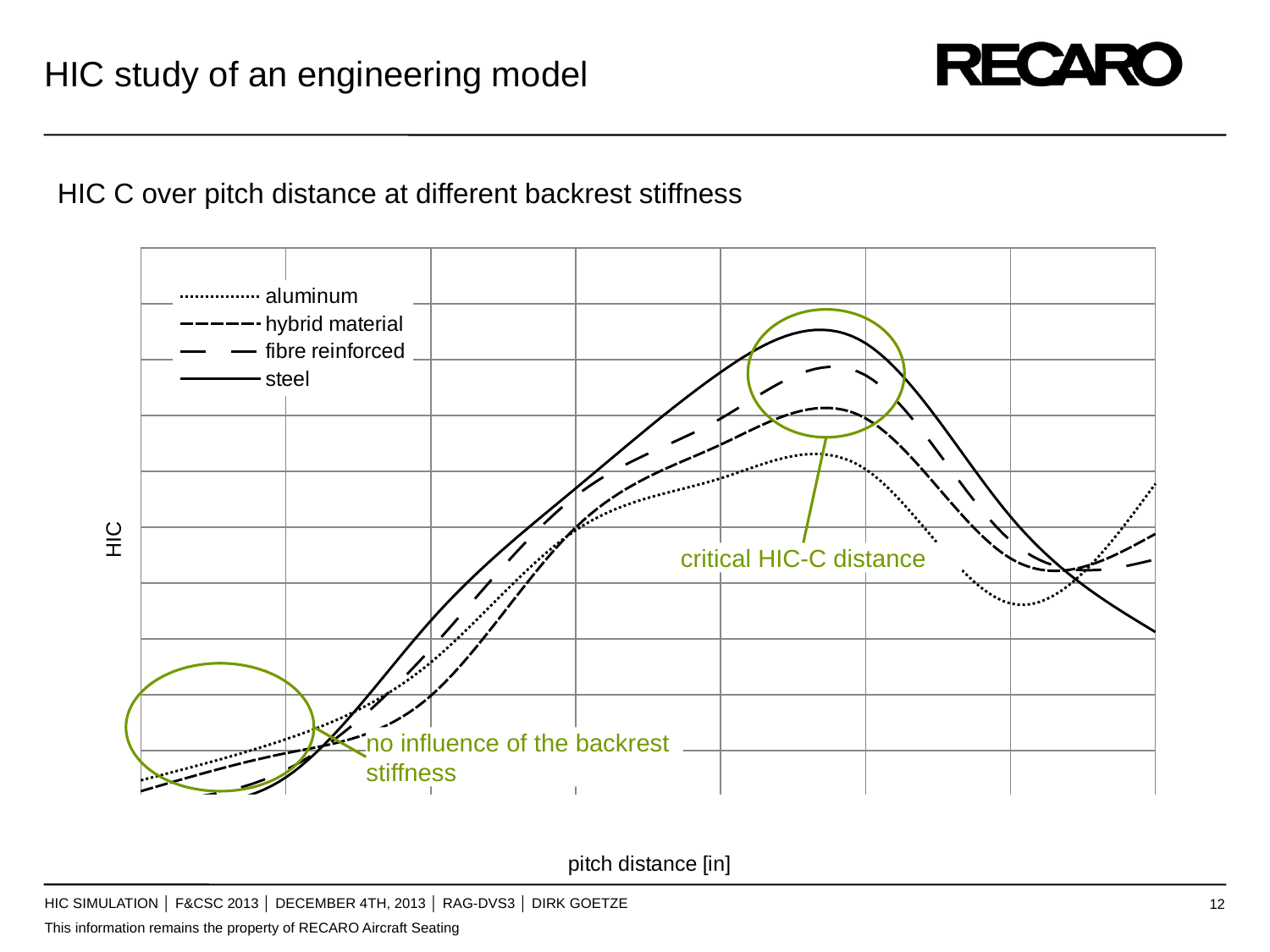
How do the HIC values change as pitch distance increases from the left edge of the chart to the peak? they rise Which series has the lowest peak HIC value? aluminum After the peak, do the HIC values rise or fall as pitch distance increases? they fall Which series reaches the highest peak HIC value? steel At the peak region, which series has the larger HIC value, fibre reinforced or hybrid material? fibre reinforced What is the label of the x axis? pitch distance [in] What is the title of the chart? HIC C over pitch distance at different backrest stiffness What kind of chart is shown on the slide? line chart At the peak region, which series has the larger HIC value, steel or aluminum? steel How many series does the legend list? 4